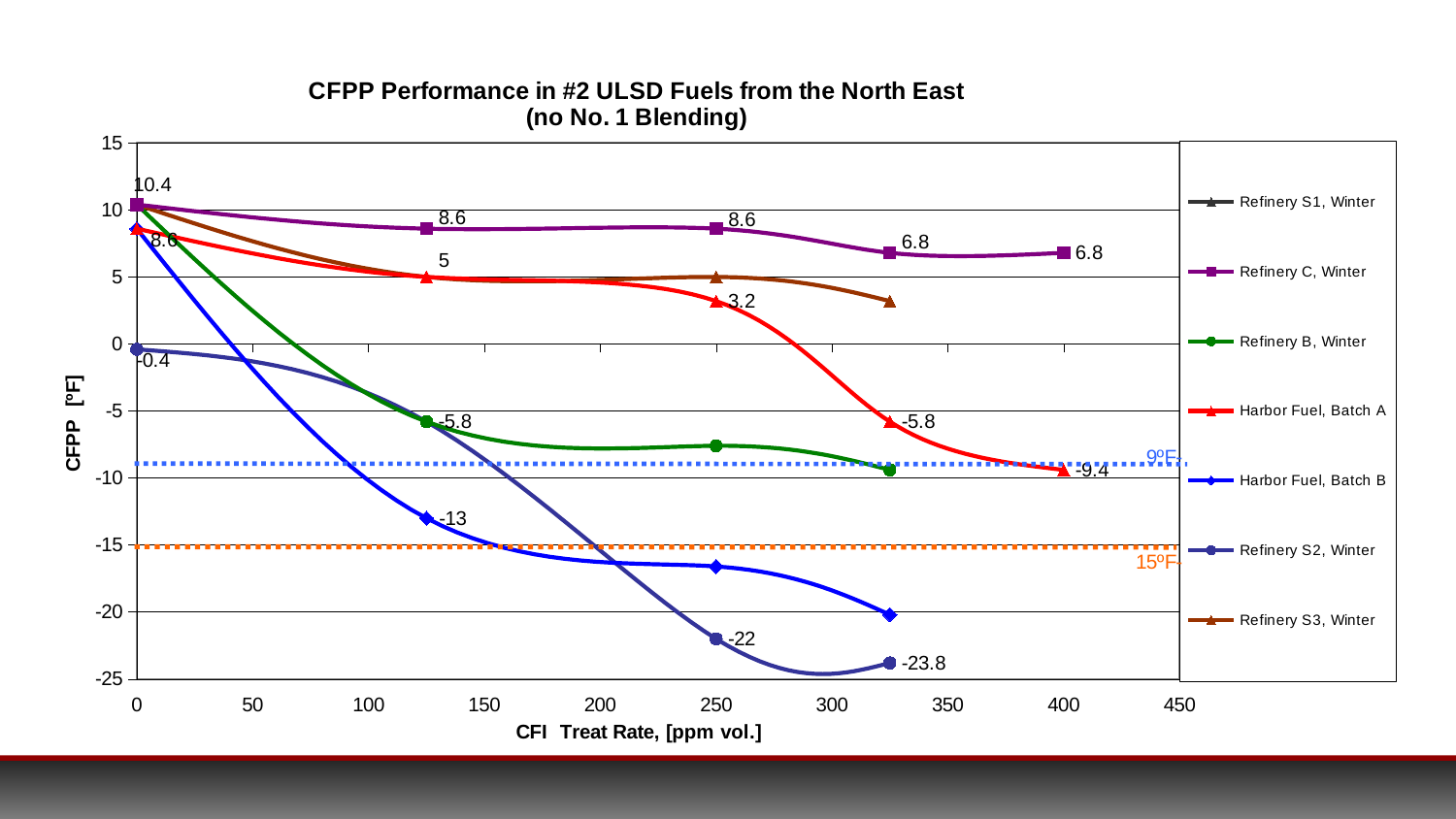
What is the CFPP value for Refinery C, Winter at a CFI treat rate of 400 ppm vol.? 6.8 How many series does the legend list? 7 By how much does the CFPP of Refinery C, Winter drop between 0 and 400 ppm vol.? 3.6 What is the title of the x axis? CFI Treat Rate, [ppm vol.] At a CFI treat rate of 325 ppm vol., which has the higher CFPP: Refinery C, Winter or Refinery S2, Winter? Refinery C, Winter Is the CFPP value for Harbor Fuel, Batch B at 325 ppm vol. greater or less than -15? less What is the CFPP value for Harbor Fuel, Batch B at a CFI treat rate of 125 ppm vol.? -13 Does the CFPP of Harbor Fuel, Batch A rise or fall as the CFI treat rate increases? fall What is the CFPP value for Refinery S2, Winter at a CFI treat rate of 0 ppm vol.? -0.4 What kind of chart is shown on the slide? line chart What is the CFPP value for Harbor Fuel, Batch A at a CFI treat rate of 400 ppm vol.? -9.4 What is the CFPP value for Refinery S2, Winter at a CFI treat rate of 250 ppm vol.? -22